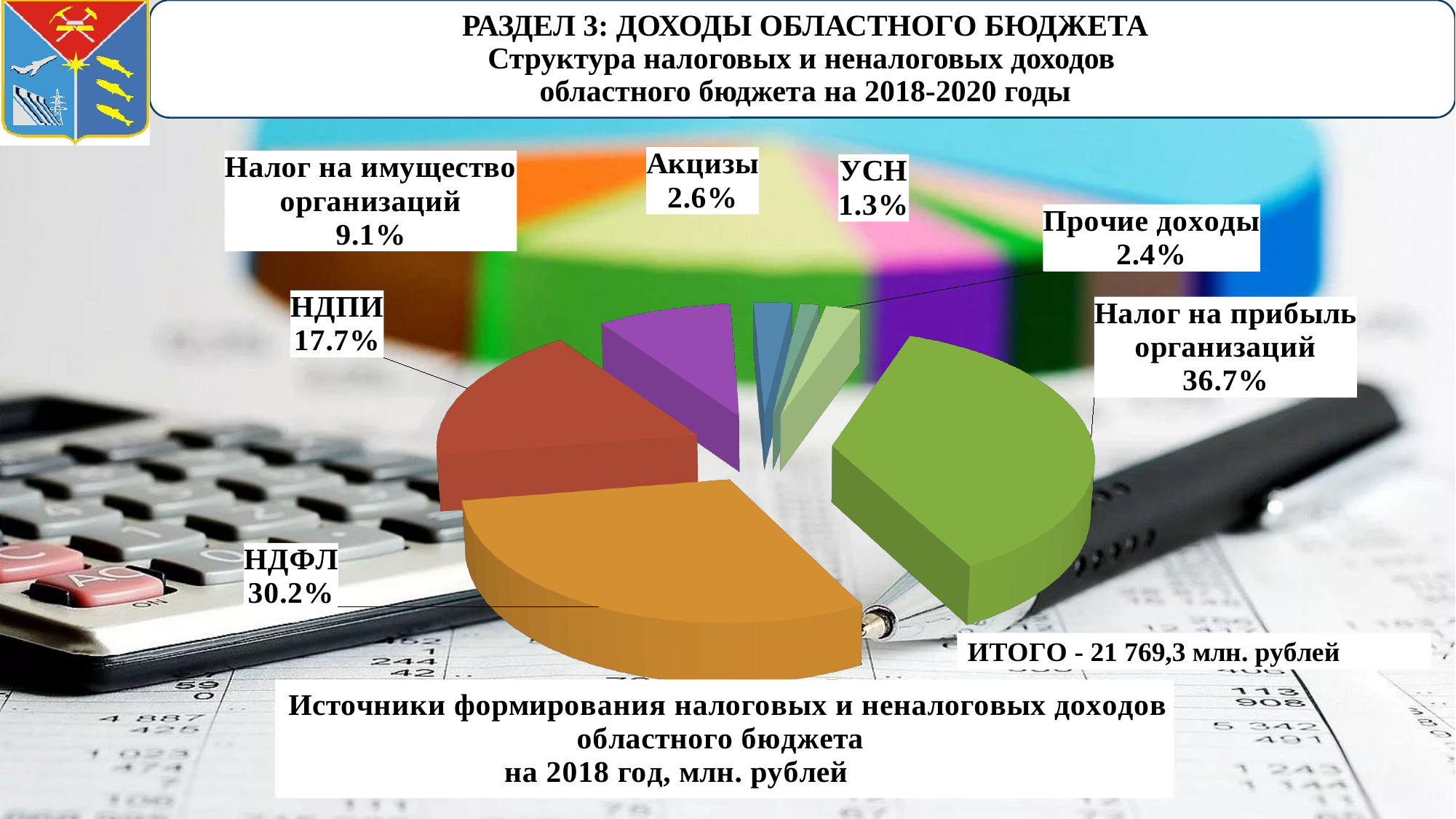
What kind of chart is shown on the slide? pie chart What share of the pie does Налог на имущество организаций have? 9.1% What total amount in million rubles is stated next to the pie chart (ИТОГО)? 21 769,3 млн. рублей What share of the pie does УСН have? 1.3% What share of the pie does Налог на прибыль организаций have? 36.7% Which category has the largest share of the pie? Налог на прибыль организаций Which category has the smallest share of the pie? УСН What is the difference in percentage points between Налог на прибыль организаций and НДФЛ? 6.5 What share of the pie does НДПИ have? 17.7% How many slices does the pie chart have? 7 Which is larger, the share for Акцизы or the share for Прочие доходы? Акцизы What share of the pie does НДФЛ have? 30.2%